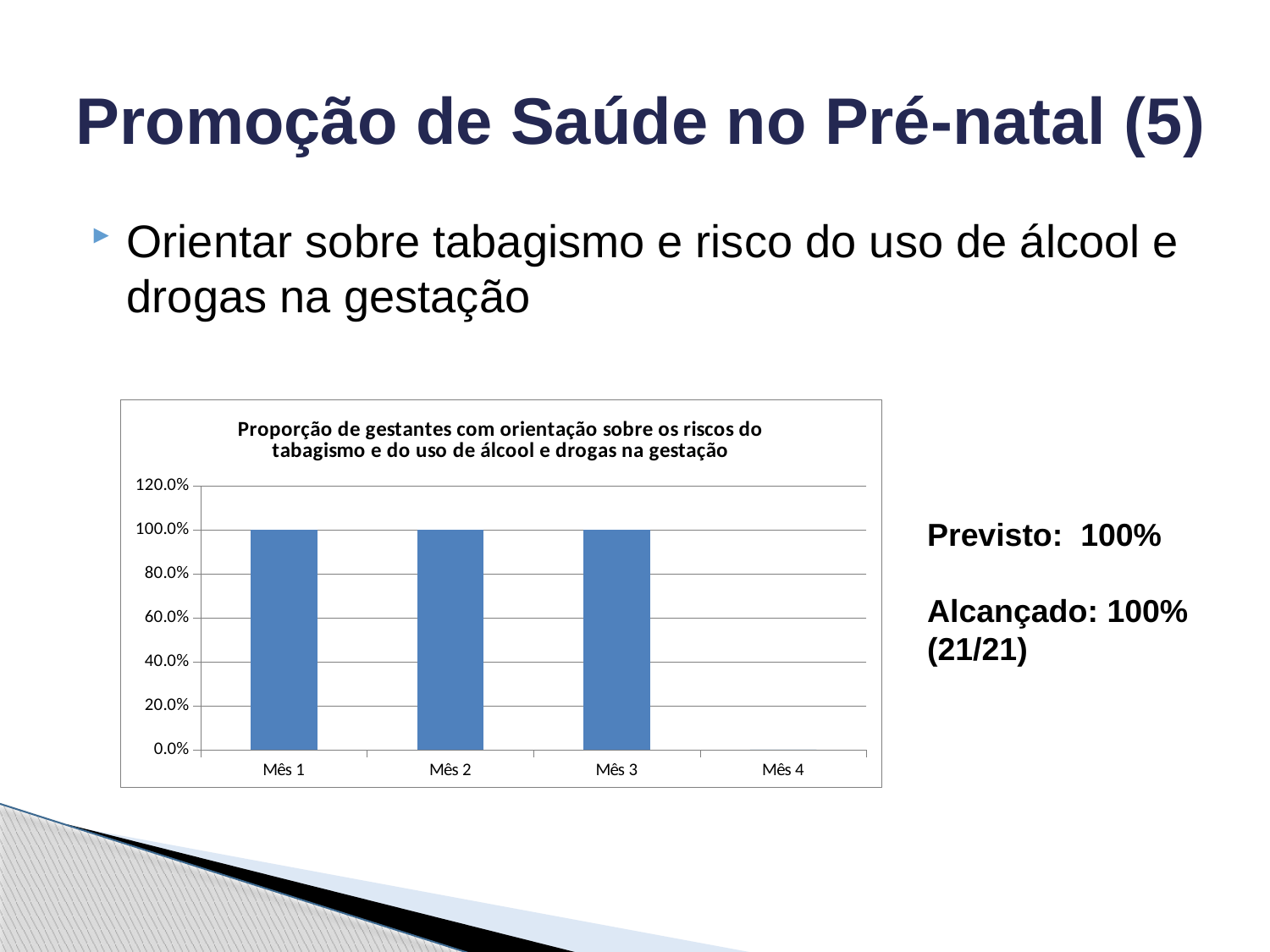
Which is larger, the value for Mês 1 or the value for Mês 4? Mês 1 How many categories are shown on the x axis of the chart? 4 What kind of chart is shown on the slide? bar chart What is the highest tick value shown on the y axis of the chart? 120.0% Is the value for Mês 3 greater or less than 80.0%? greater What is the difference between the values for Mês 1 and Mês 2? 0.0% What is the title of the chart? Proporção de gestantes com orientação sobre os riscos do tabagismo e do uso de álcool e drogas na gestação What is the value for Mês 2 in the chart? 100.0% What is the value for Mês 3 in the chart? 100.0% What is the value for Mês 1 in the chart? 100.0% Which category has the lowest value in the chart? Mês 4